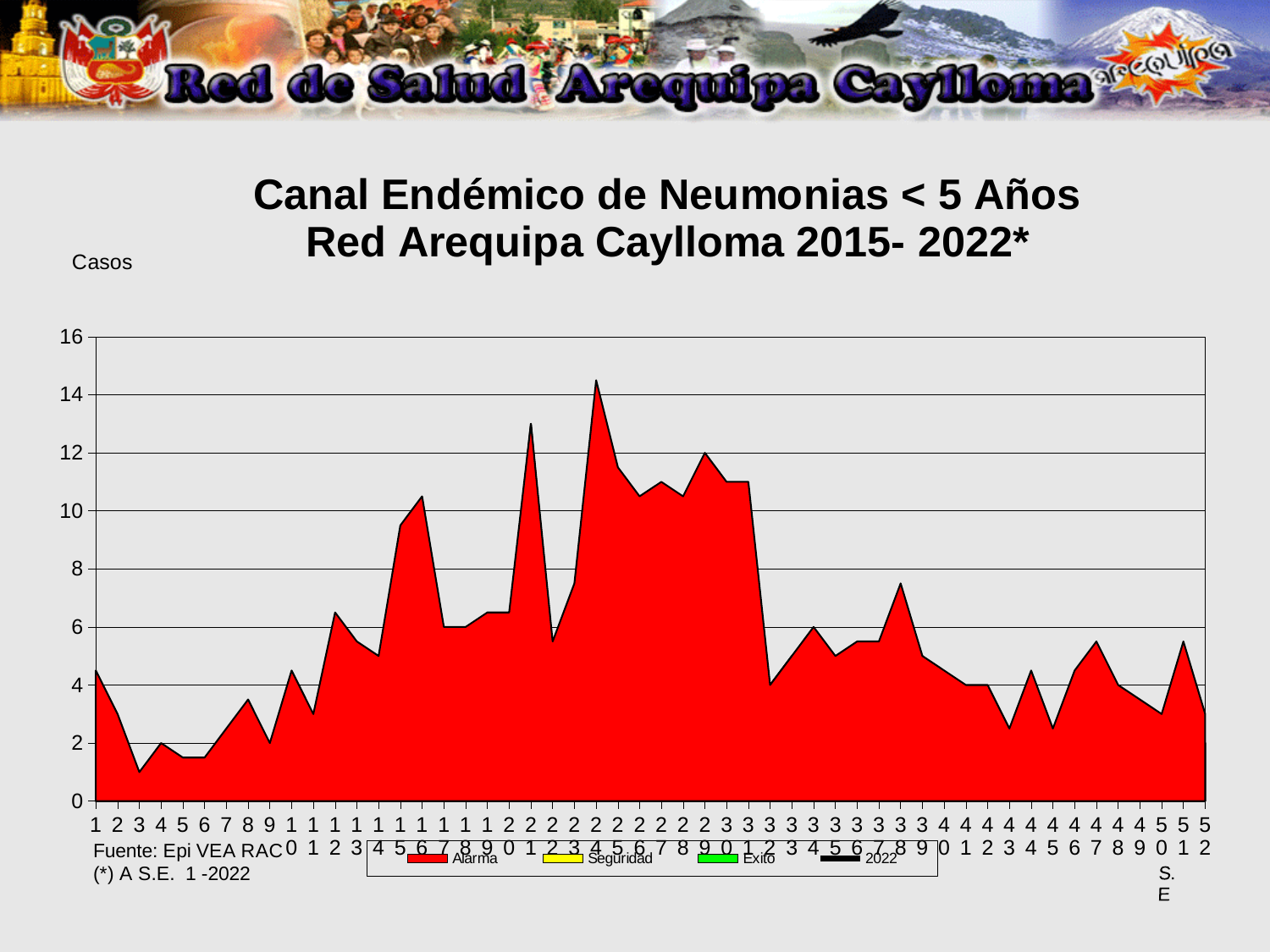
What colour is the Alarma series in the legend? red How many entries does the chart legend list? 4 How many epidemiological weeks are plotted along the x axis? 52 What kind of chart is shown on the slide? area chart Is the value for week 21 greater or less than 12? greater Is the value for week 32 greater or less than 6? less Is the value for week 25 greater or less than 12? less Do the values rise or fall from week 25 to week 32? fall Which week has the larger value, week 21 or week 32? week 21 At which week does the red Alarma area reach its highest value? week 24